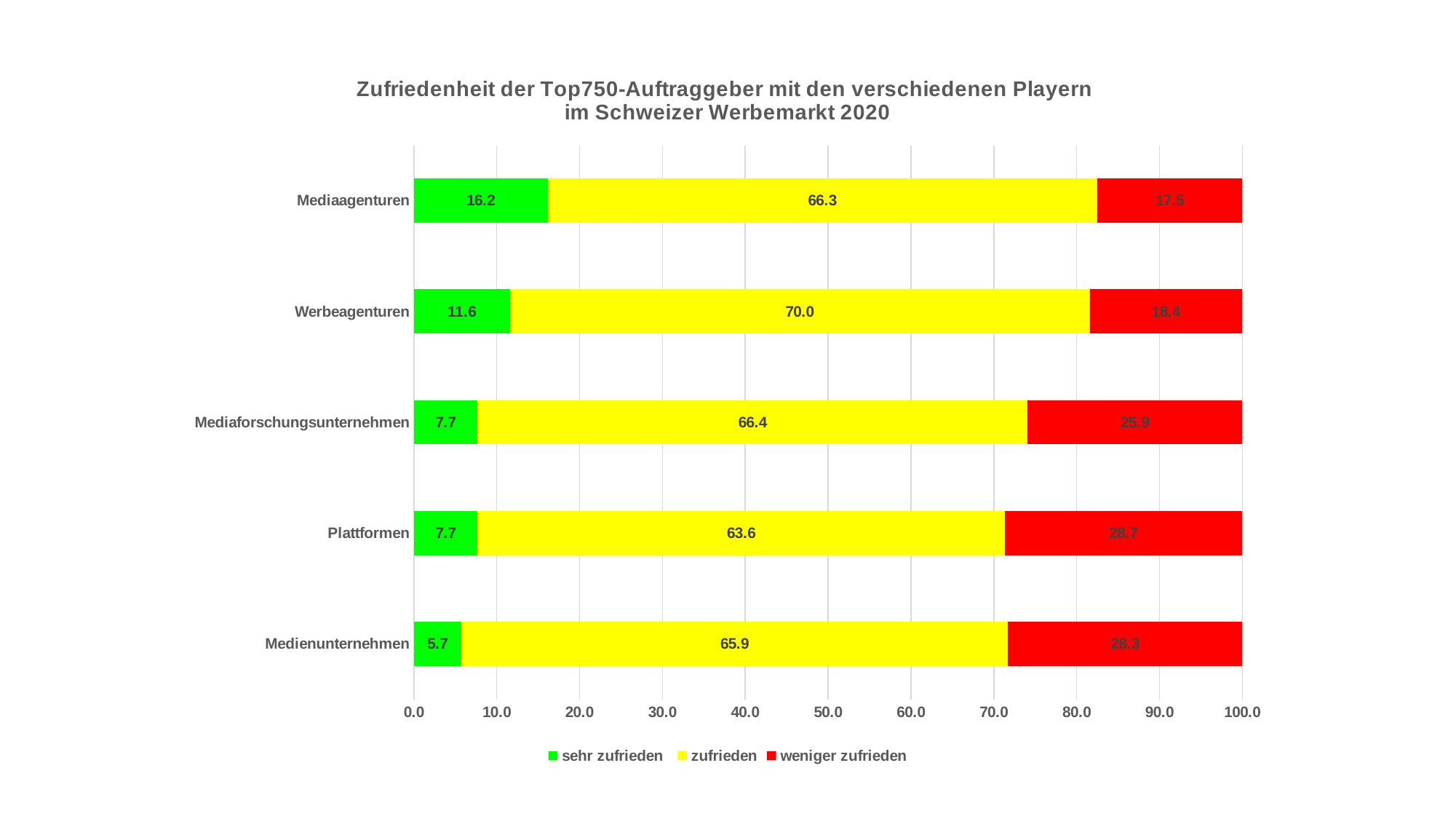
Which category has the highest value for "sehr zufrieden"? Mediaagenturen Which category has the lowest value for "sehr zufrieden"? Medienunternehmen Which has the larger "zufrieden" value, Werbeagenturen or Mediaagenturen? Werbeagenturen Which category has the highest value for "weniger zufrieden"? Plattformen How many categories are shown on the chart? 5 How many series does the legend list? 3 What is the difference between the "weniger zufrieden" values for Mediaforschungsunternehmen and Mediaagenturen? 8.4 What is the value for "sehr zufrieden" for Mediaagenturen? 16.2 What is the value for "weniger zufrieden" for Plattformen? 28.7 What is the total of the stacked bar for Medienunternehmen? 99.9 What is the value for "zufrieden" for Werbeagenturen? 70.0 What kind of chart is shown on the slide? Stacked bar chart